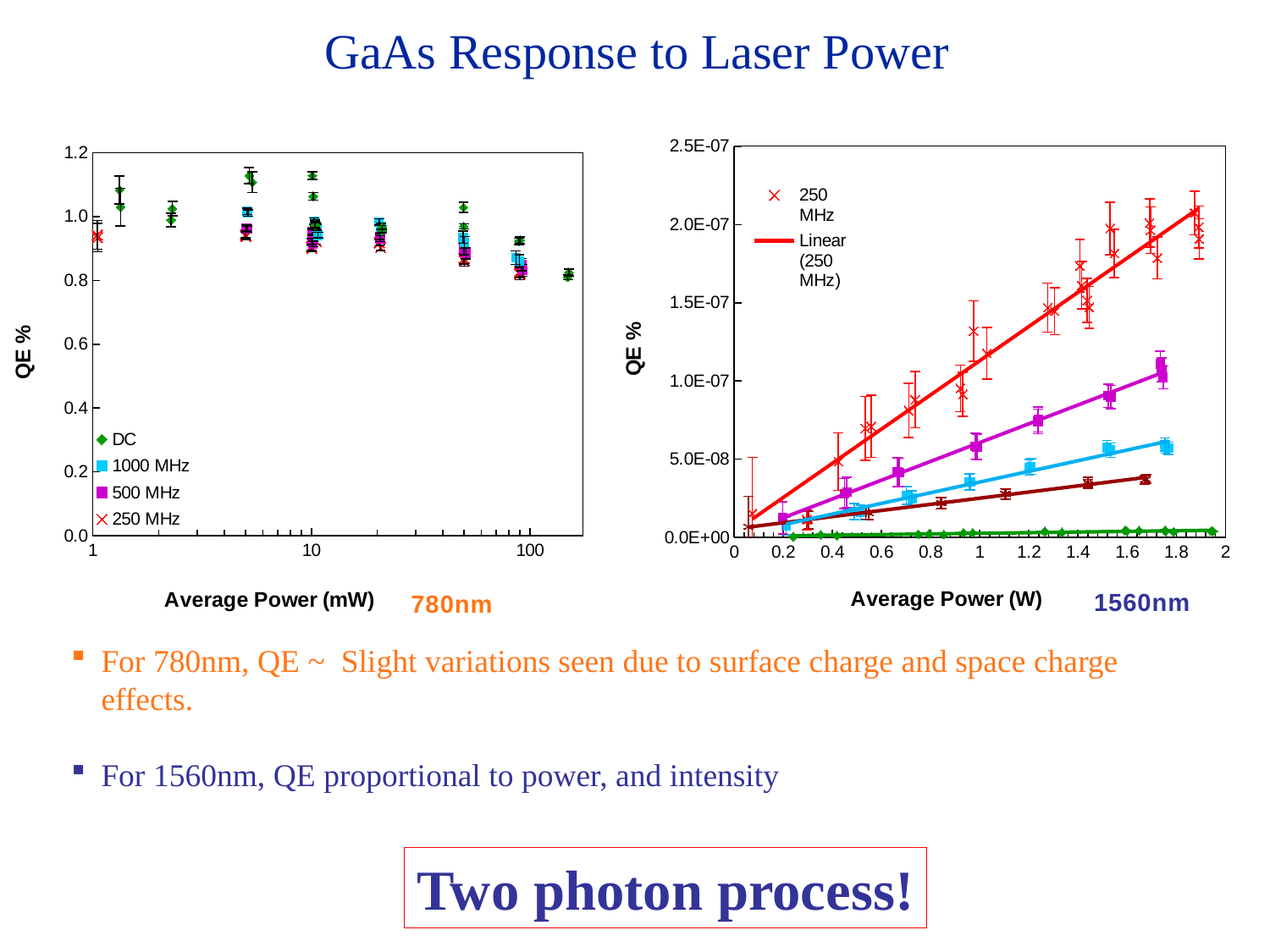
How many entries does the legend of the 1560nm chart on the right list? 2 What kind of chart is the 780nm chart on the left? scatter chart In the 780nm chart on the left, do the QE % values rise or fall as average power increases from 10 mW to 100 mW? fall In the 780nm chart on the left, what is the label of the x axis? Average Power (mW) In the 780nm chart on the left, is the DC value at about 150 mW greater or less than 1.0? less In the 1560nm chart on the right, what is the label of the y axis? QE % In the 1560nm chart on the right, which series has the highest QE % at about 1.8 W, the red 250 MHz series or the magenta series? the red 250 MHz series In the 780nm chart on the left, are the QE % values at 100 mW greater or less than 0.6? greater In the 1560nm chart on the right, is the 250 MHz value at about 0.4 W greater or less than 1.0E-07? less In the 1560nm chart on the right, does the 250 MHz series rise or fall as average power increases? rise How many series does the legend of the 780nm chart on the left list? 4